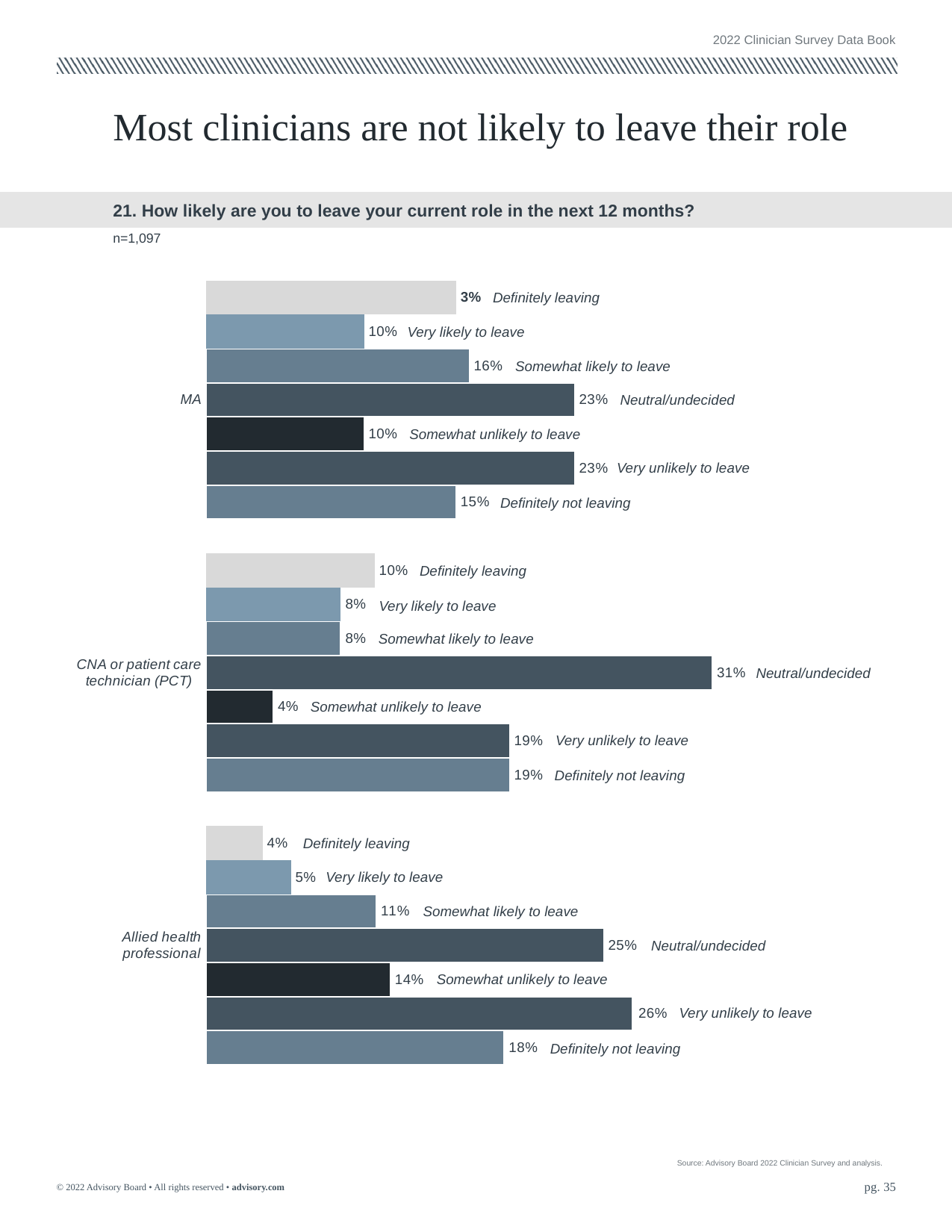
What is the difference between the neutral/undecided percentage for CNAs or PCTs and for allied health professionals? 6% Which response has the lowest percentage among allied health professionals? Definitely leaving Which response has the highest percentage among CNAs or patient care technicians (PCT)? Neutral/undecided What kind of chart is used on this slide? Bar chart What percentage of MAs said they are neutral/undecided about leaving their current role? 23% What is the sample size (n) shown for the survey question on this slide? n=1,097 How many response categories are shown for each clinician group? 7 What percentage of CNAs or patient care technicians (PCT) said they are definitely leaving? 10% Which group has a larger percentage of respondents who are somewhat unlikely to leave: MA or allied health professional? Allied health professional How many clinician groups are shown in the chart? 3 Which response has the lowest percentage among MAs? Definitely leaving What percentage of allied health professionals said they are very unlikely to leave? 26%